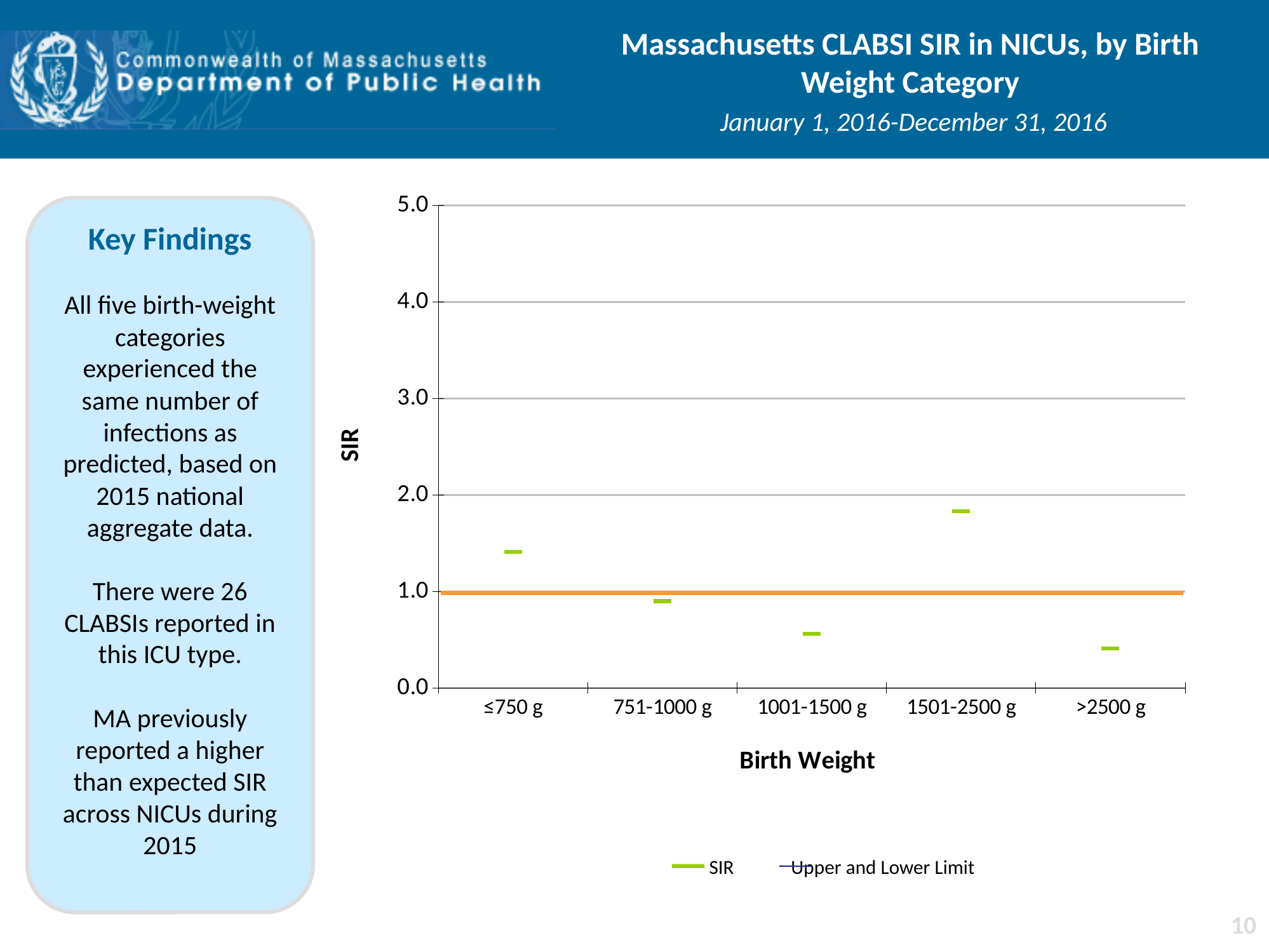
What is the label of the chart's horizontal axis? Birth Weight Which birth weight category has the lowest SIR in the chart? >2500 g Is the SIR for the ≤750 g category greater or less than 1.0? greater Is the SIR for the >2500 g category greater or less than 1.0? less Which has the larger SIR, the ≤750 g category or the 751-1000 g category? ≤750 g What is the label of the chart's vertical axis? SIR How many birth weight categories are shown on the x axis of the chart? 5 Which birth weight category has the highest SIR in the chart? 1501-2500 g Which has the larger SIR, the 1501-2500 g category or the ≤750 g category? 1501-2500 g Is the SIR for the 1501-2500 g category greater or less than 2.0? less How many series does the chart legend list? 2